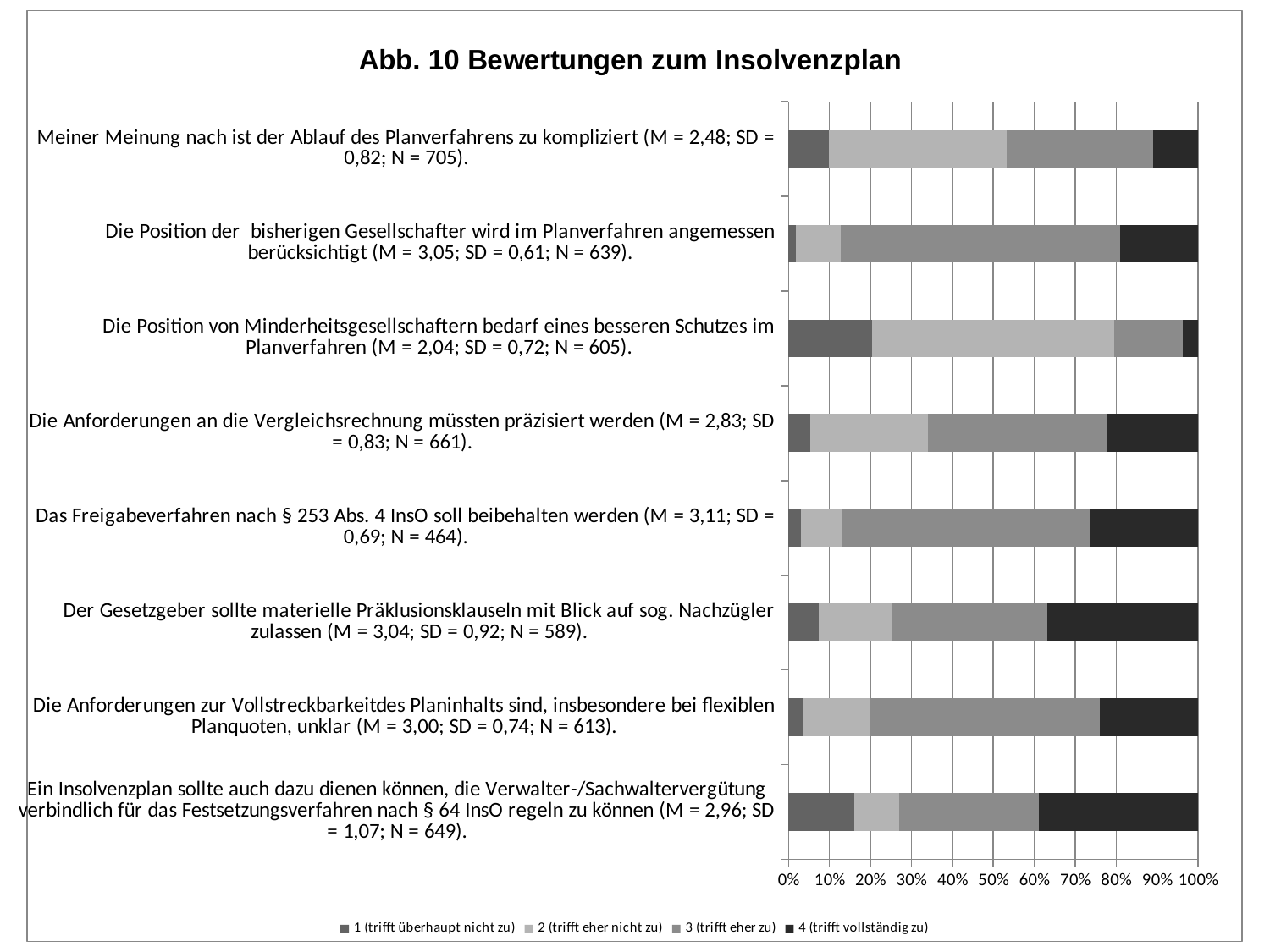
What is the title of the chart? Abb. 10 Bewertungen zum Insolvenzplan What kind of chart is shown on the slide? Stacked bar chart What is the mean (M) reported for the statement 'Das Freigabeverfahren nach § 253 Abs. 4 InsO soll beibehalten werden'? 3,11 Is the share of '4 (trifft vollständig zu)' for the statement 'Ein Insolvenzplan sollte auch dazu dienen können, die Verwalter-/Sachwaltervergütung verbindlich ... regeln zu können' greater or less than 30%? greater Is the share of '1 (trifft überhaupt nicht zu)' for the statement 'Die Position von Minderheitsgesellschaftern bedarf eines besseren Schutzes im Planverfahren' greater or less than 10%? greater What is the difference in N between the statement 'Meiner Meinung nach ist der Ablauf des Planverfahrens zu kompliziert' (N = 705) and 'Das Freigabeverfahren nach § 253 Abs. 4 InsO soll beibehalten werden' (N = 464)? 241 How many series does the legend list? 4 What is the N reported for the statement 'Meiner Meinung nach ist der Ablauf des Planverfahrens zu kompliziert'? 705 Which statement has the lowest mean (M) shown in its label? Die Position von Minderheitsgesellschaftern bedarf eines besseren Schutzes im Planverfahren (M = 2,04) Which statement has the highest N shown in its label? Meiner Meinung nach ist der Ablauf des Planverfahrens zu kompliziert (N = 705) How many statements (categories) are plotted in the chart? 8 Which legend entry is shown in the darkest (black) colour? 4 (trifft vollständig zu)